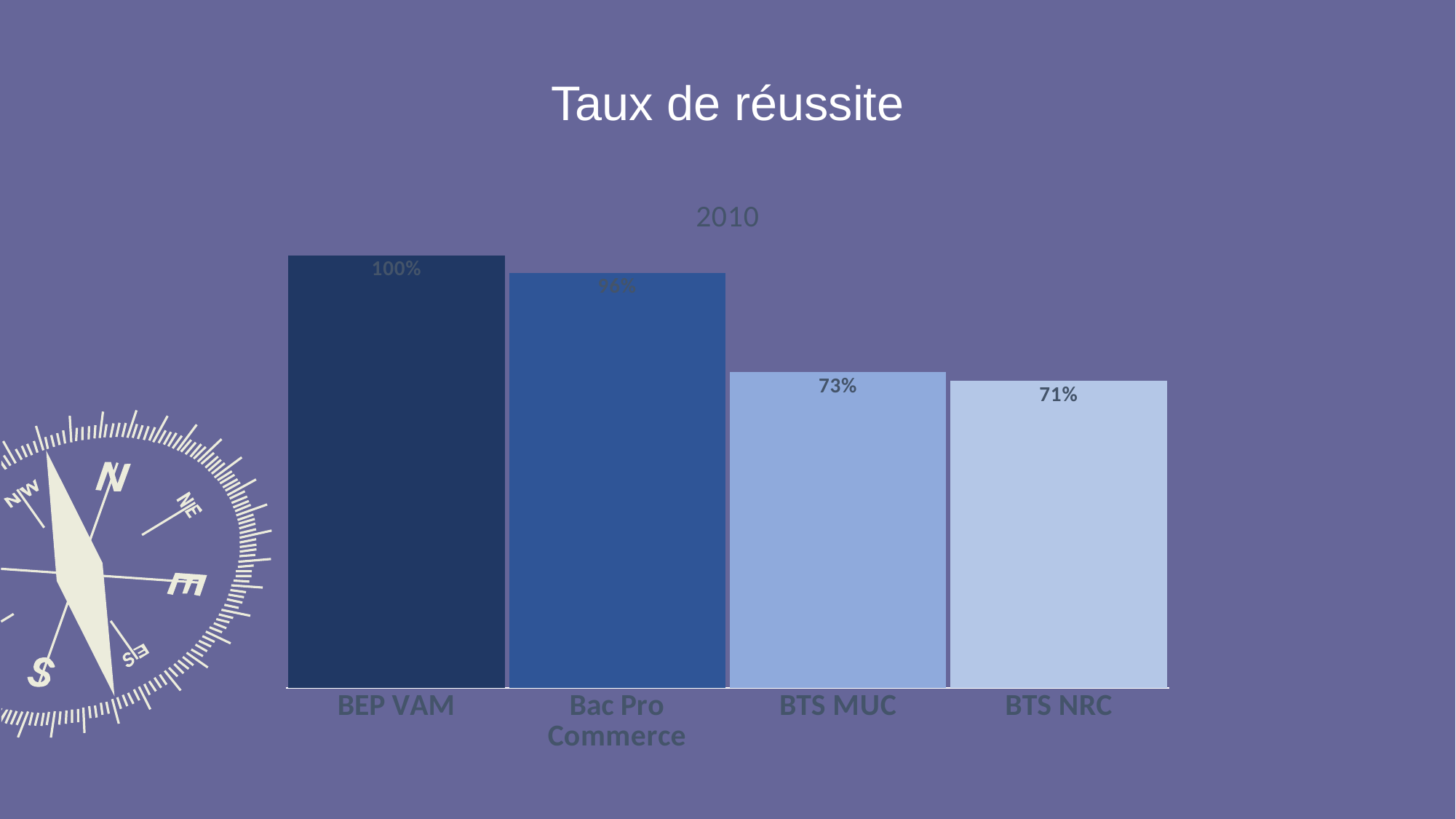
What is the value for Bac Pro Commerce? 96% What is the value for BTS NRC? 71% Which is larger, the value for Bac Pro Commerce or the value for BTS MUC? Bac Pro Commerce Do the values rise or fall from left to right across the categories? Fall What kind of chart is shown on the slide? Bar chart How many categories are shown in the chart? 4 Which category has the lowest value? BTS NRC Which category has the highest value? BEP VAM What is the difference between the values for BEP VAM and BTS MUC? 27 percentage points What is the value for BTS MUC? 73% What is the value for BEP VAM? 100% What is the difference between the values for BTS MUC and BTS NRC? 2 percentage points